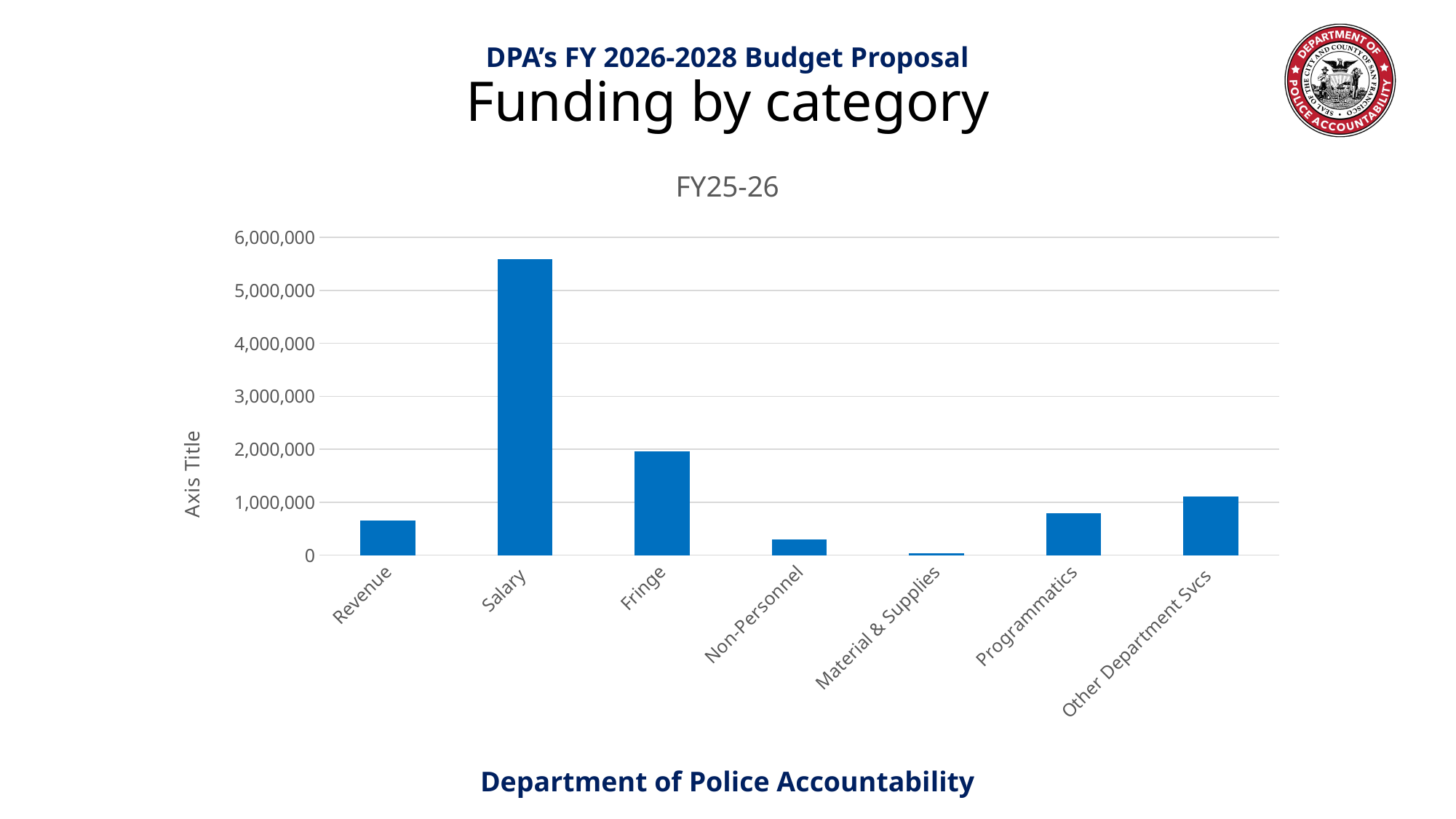
Is the value for Revenue greater or less than 1,000,000? less What kind of chart is shown on the slide? bar chart Is the value for Non-Personnel greater or less than 1,000,000? less Which is larger, the value for Programmatics or the value for Non-Personnel? Programmatics Which category has the lowest value? Material & Supplies Is the value for Fringe greater or less than 1,000,000? greater What is the title of the chart? FY25-26 Which category has the highest value? Salary What label is shown on the vertical axis of the chart? Axis Title Which is larger, the value for Fringe or the value for Other Department Svcs? Fringe How many categories are plotted on the chart? 7